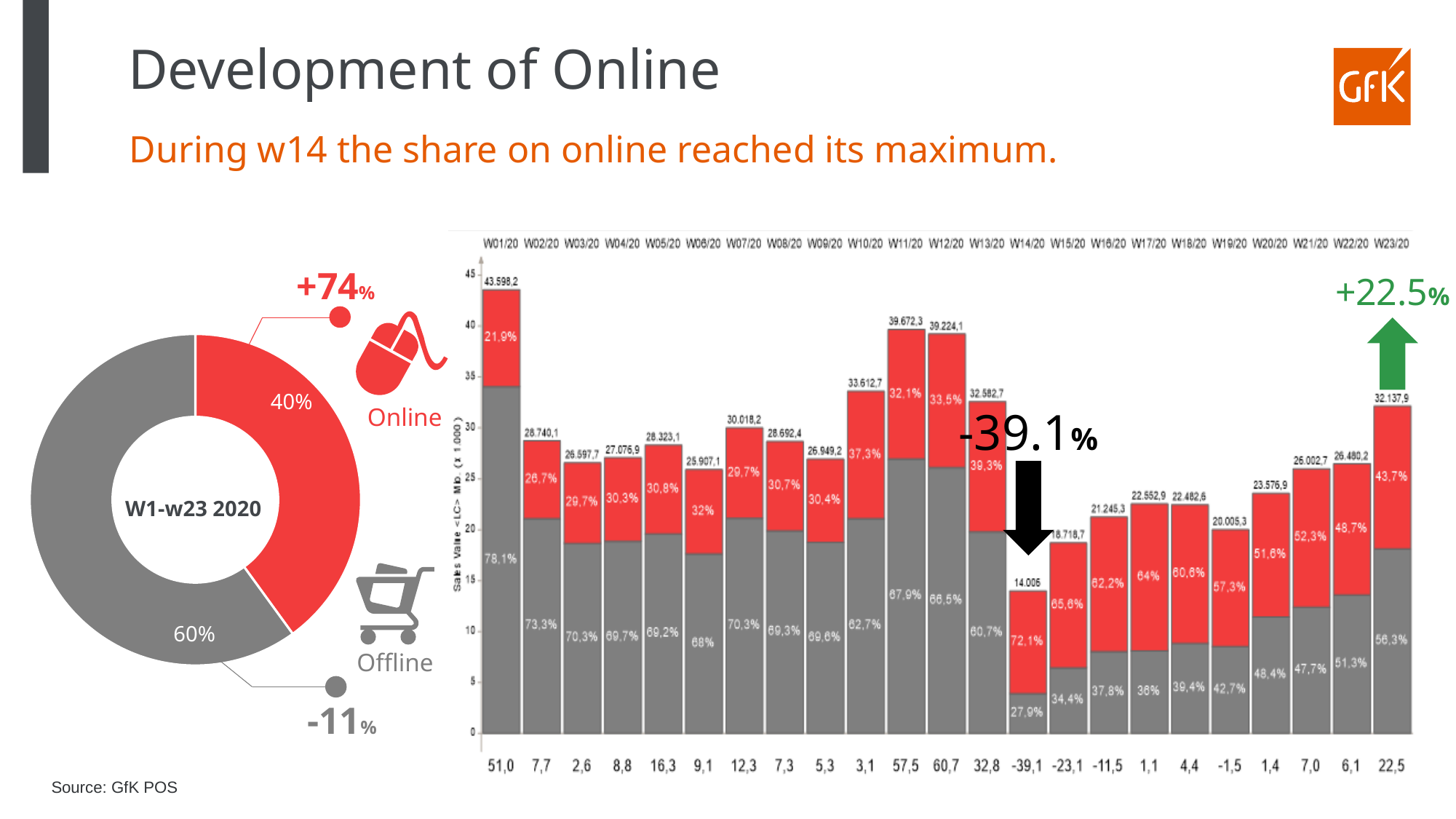
In the bar chart on the right, what is the total sales value labelled for W23/20? 32.137,9 In the bar chart on the right, how many weeks are shown on the x axis? 23 What kind of chart is the chart on the right of the slide? Stacked bar chart In the donut chart on the left, what share does Online have? 40% What kind of chart is the chart on the left of the slide? Donut (pie) chart In the bar chart on the right, is the total sales value for W11/20 greater or less than 35? greater In the bar chart on the right, which week has the lowest total sales value? W14/20 In the bar chart on the right, which week has the highest total sales value? W01/20 In the bar chart on the right, which week has the larger total sales value, W10/20 or W13/20? W10/20 In the donut chart on the left, what share does Offline have? 60% In the bar chart on the right, what is the total sales value labelled for W14/20? 14.006 In the bar chart on the right, what is the online share (red segment) for W14/20? 72.1%